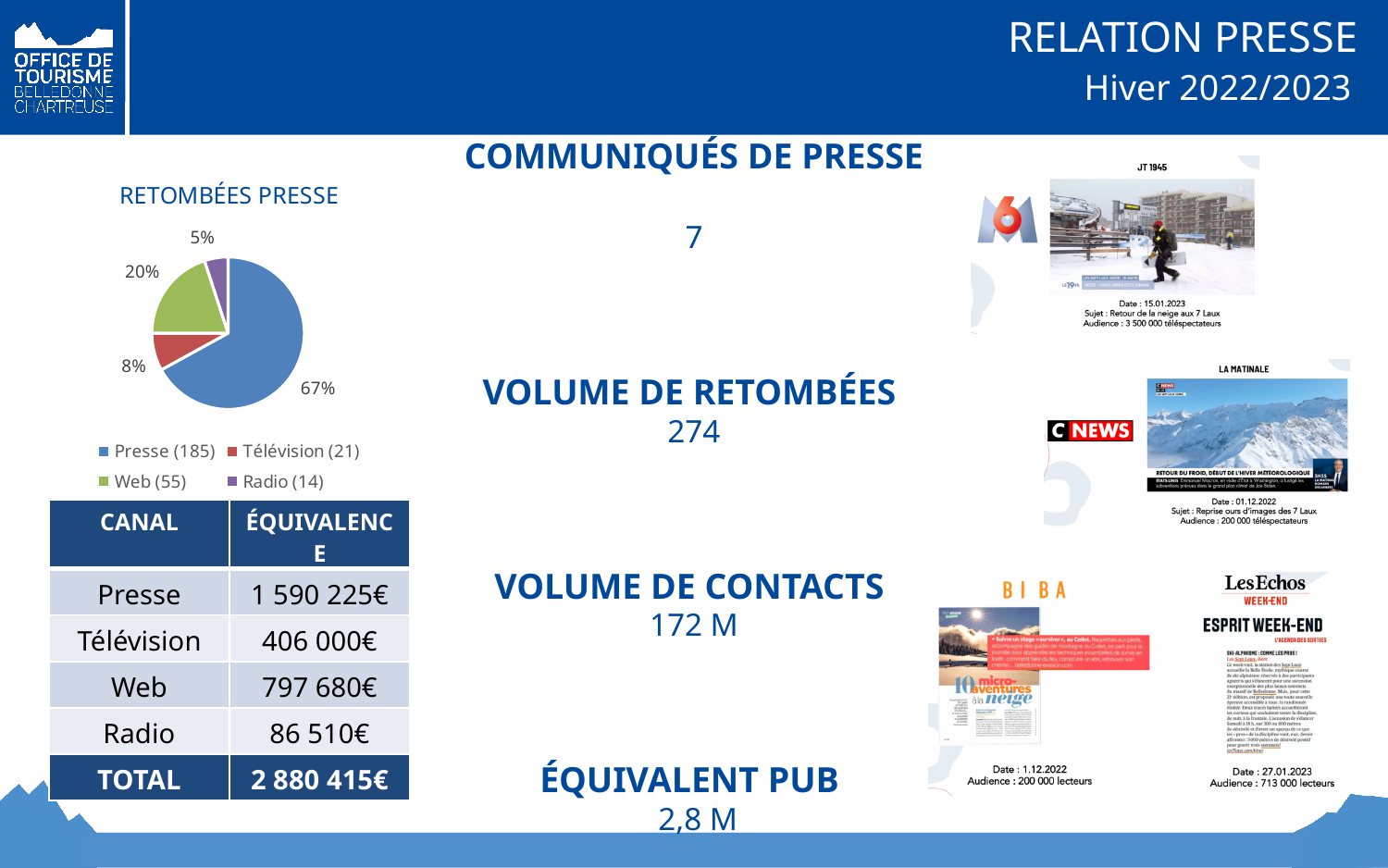
How many slices does the RETOMBÉES PRESSE pie chart have? 4 What percentage of the RETOMBÉES PRESSE pie does Web represent? 20% What percentage of the RETOMBÉES PRESSE pie does Radio represent? 5% How many entries does the legend of the RETOMBÉES PRESSE pie chart list? 4 What kind of chart is shown under the title RETOMBÉES PRESSE? Pie chart According to the legend of the RETOMBÉES PRESSE pie chart, what number is shown in parentheses next to Presse? 185 Which category has the largest slice in the RETOMBÉES PRESSE pie chart? Presse In the RETOMBÉES PRESSE pie chart, what is the difference in percentage points between the Presse slice and the Web slice? 47 percentage points Which category has the smallest slice in the RETOMBÉES PRESSE pie chart? Radio What percentage of the RETOMBÉES PRESSE pie does Télévision represent? 8% In the RETOMBÉES PRESSE pie chart, which slice is larger: Web or Télévision? Web